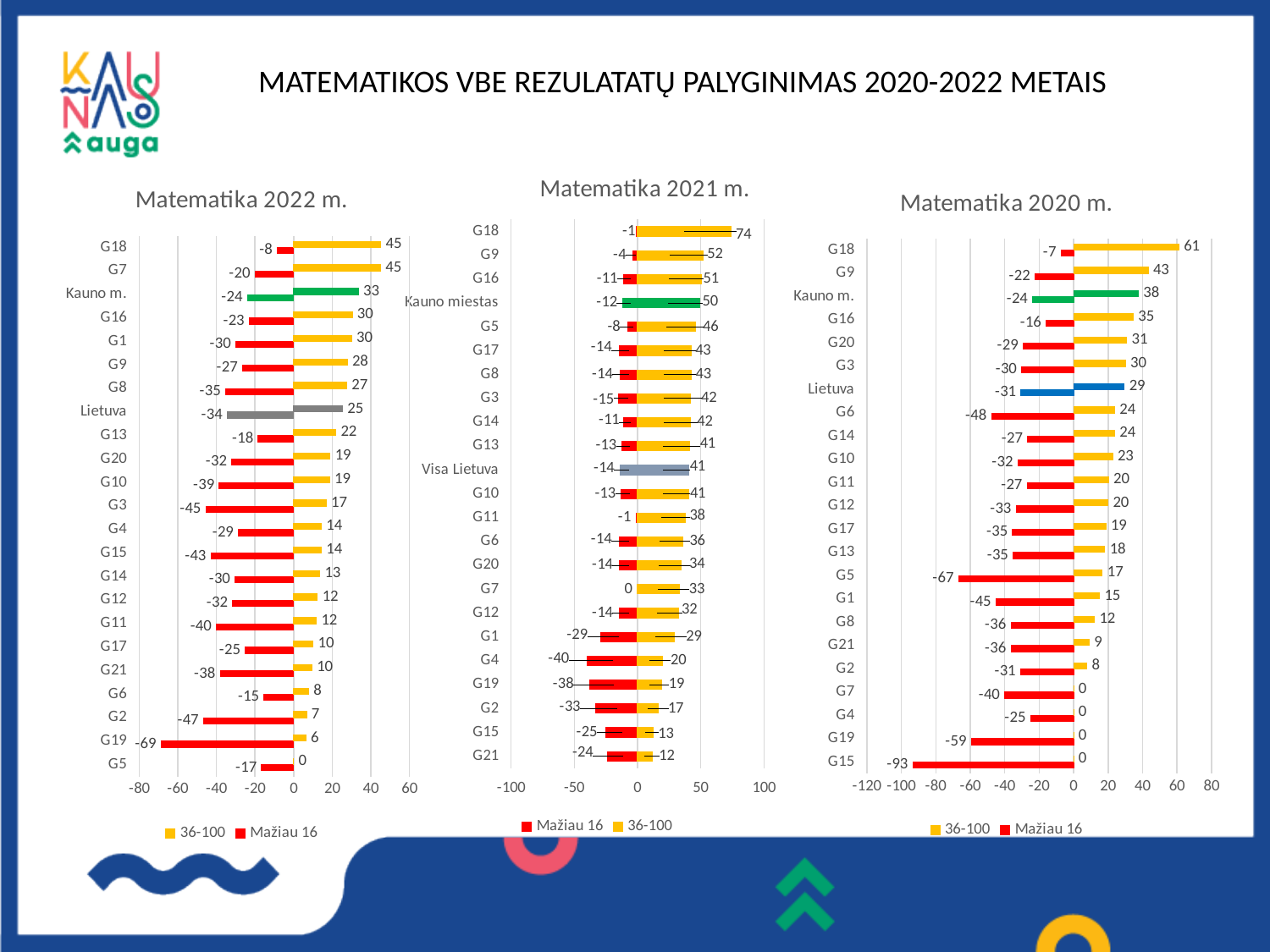
In the 'Matematika 2020 m.' chart, what is the 'Mažiau 16' value for G15? -93 In the 'Matematika 2021 m.' chart, what is the '36-100' value for Kauno miestas? 50 In the 'Matematika 2022 m.' chart, which is larger, the '36-100' value for Kauno m. or for Lietuva? Kauno m. How many series does the legend of the 'Matematika 2022 m.' chart list? 2 What type of chart is 'Matematika 2021 m.'? Bar chart In the 'Matematika 2020 m.' chart, what is the '36-100' value for Lietuva? 29 In the 'Matematika 2022 m.' chart, what is the '36-100' value for G18? 45 In the 'Matematika 2021 m.' chart, what is the '36-100' value for G21? 12 How many categories are shown in the 'Matematika 2020 m.' chart? 23 In the 'Matematika 2020 m.' chart, what is the difference between the '36-100' values for G18 and G9? 18 In the 'Matematika 2021 m.' chart, which category has the highest '36-100' value? G18 In the 'Matematika 2022 m.' chart, what is the 'Mažiau 16' value for G19? -69